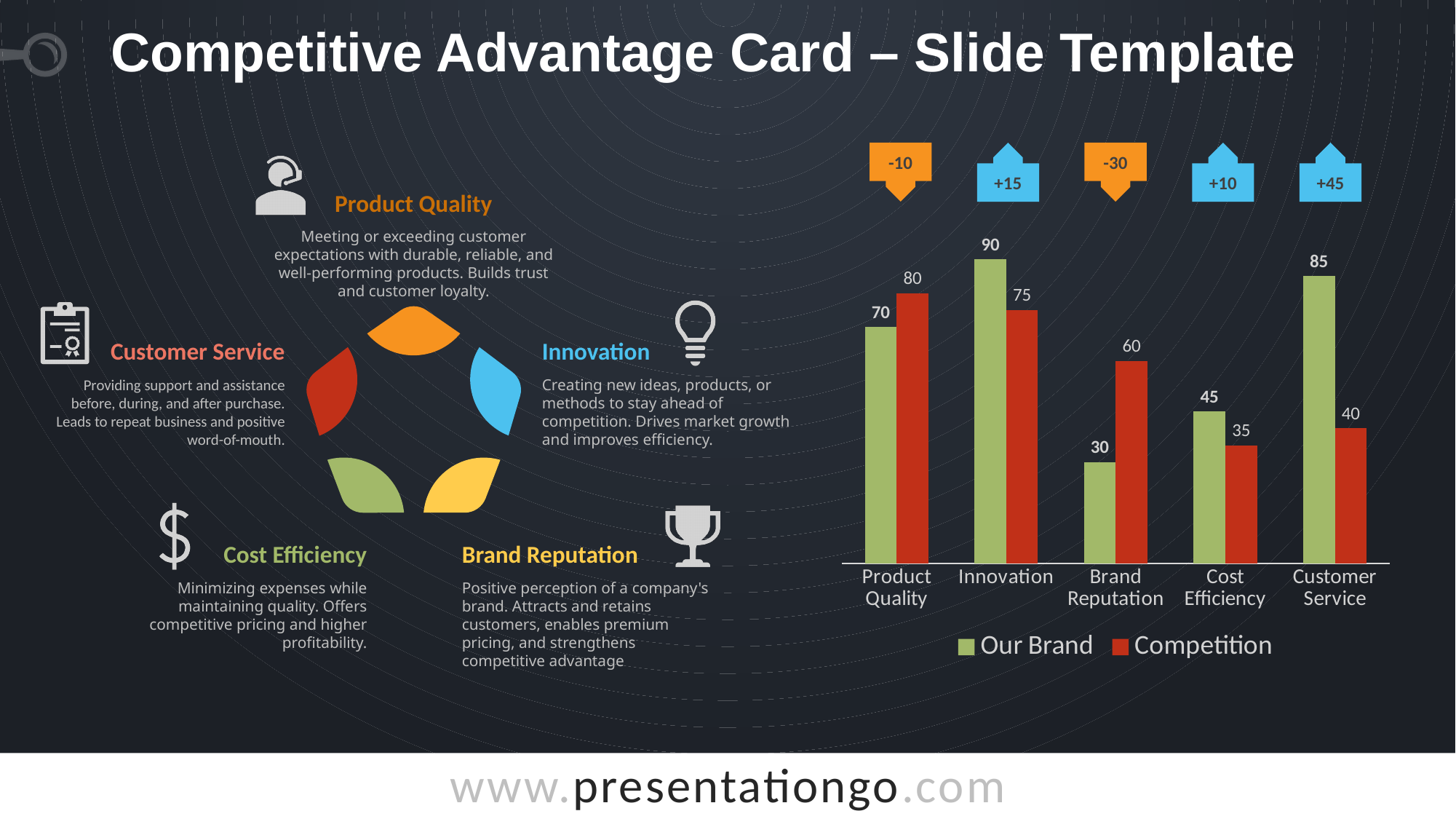
Which is larger in Product Quality, Our Brand or Competition? Competition Which category has the highest value for Our Brand? Innovation Which category has the lowest value for Competition? Cost Efficiency What is the value for Competition in Brand Reputation? 60 What is the difference between Our Brand and Competition in Customer Service? 45 How many series does the chart legend list? 2 What colour represents Competition in the chart? Red How many categories are shown on the x axis of the chart? 5 What is the difference between Competition and Our Brand in Brand Reputation? 30 What kind of chart is shown on the slide? Bar chart What is the value for Competition in Customer Service? 40 What is the value for Our Brand in Product Quality? 70